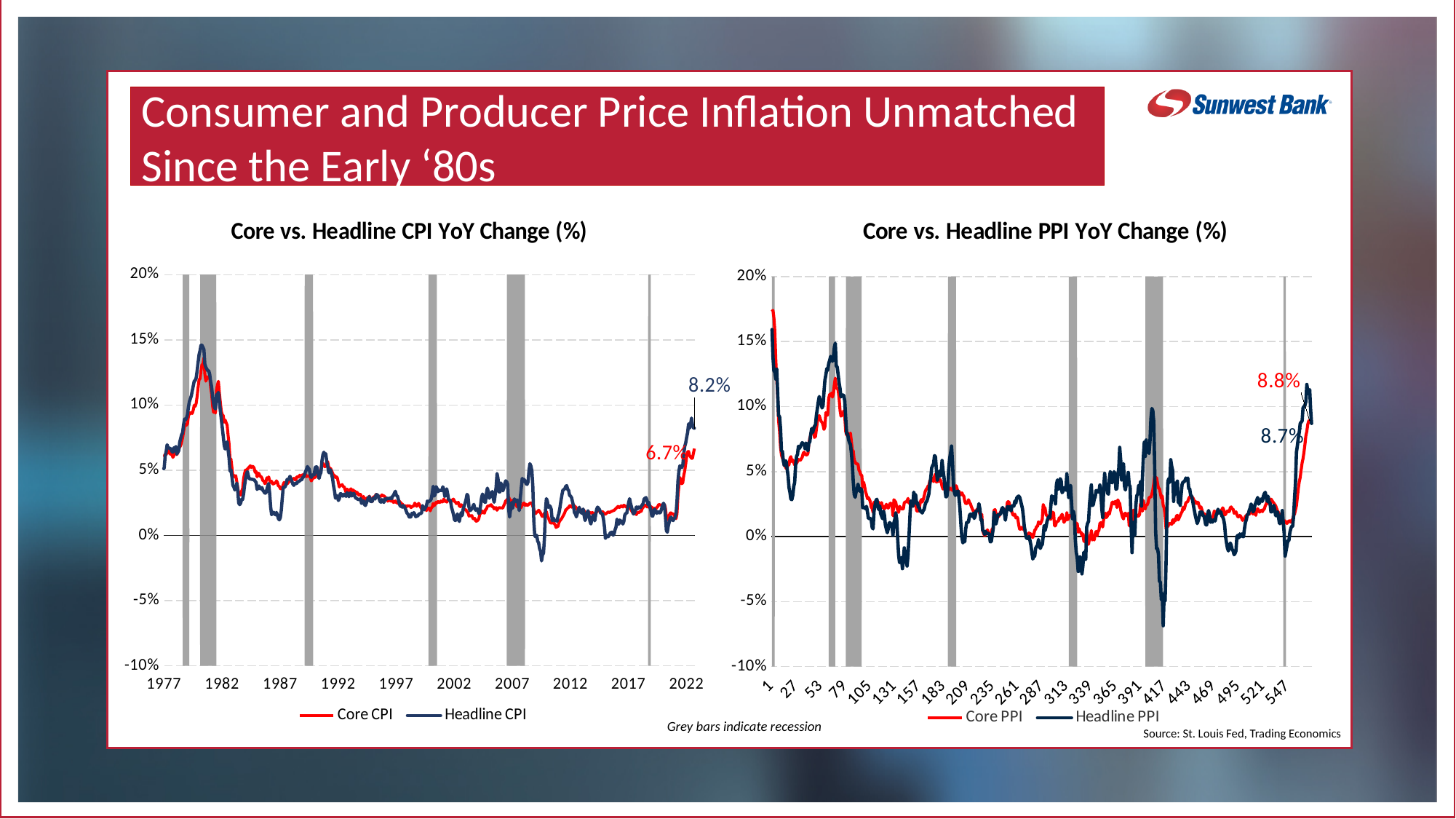
On the Core vs. Headline CPI YoY Change (%) chart, what is the latest labelled value for Core CPI? 6.7% What are the two legend entries on the Core vs. Headline PPI YoY Change (%) chart? Core PPI and Headline PPI On the Core vs. Headline PPI YoY Change (%) chart, is the lowest point of Headline PPI near period 417 greater or less than -5%? less What kind of chart is the Core vs. Headline PPI YoY Change (%) chart? Line chart According to the note on the slide, what do the grey bars on the charts indicate? Recession On the Core vs. Headline PPI YoY Change (%) chart, what is the labelled value shown in red for Core PPI? 8.8% On the Core vs. Headline PPI YoY Change (%) chart, what is the labelled value shown in dark blue for Headline PPI? 8.7% On the Core vs. Headline CPI YoY Change (%) chart, is the peak of Headline CPI around 1980 greater or less than 10%? greater On the Core vs. Headline CPI YoY Change (%) chart, what is the latest labelled value for Headline CPI? 8.2% On the Core vs. Headline CPI YoY Change (%) chart, what is the difference between the labelled Headline CPI value and the labelled Core CPI value? 1.5% On the Core vs. Headline CPI YoY Change (%) chart, which labelled value is larger, Headline CPI or Core CPI? Headline CPI How many series does the legend of the Core vs. Headline CPI YoY Change (%) chart list? 2